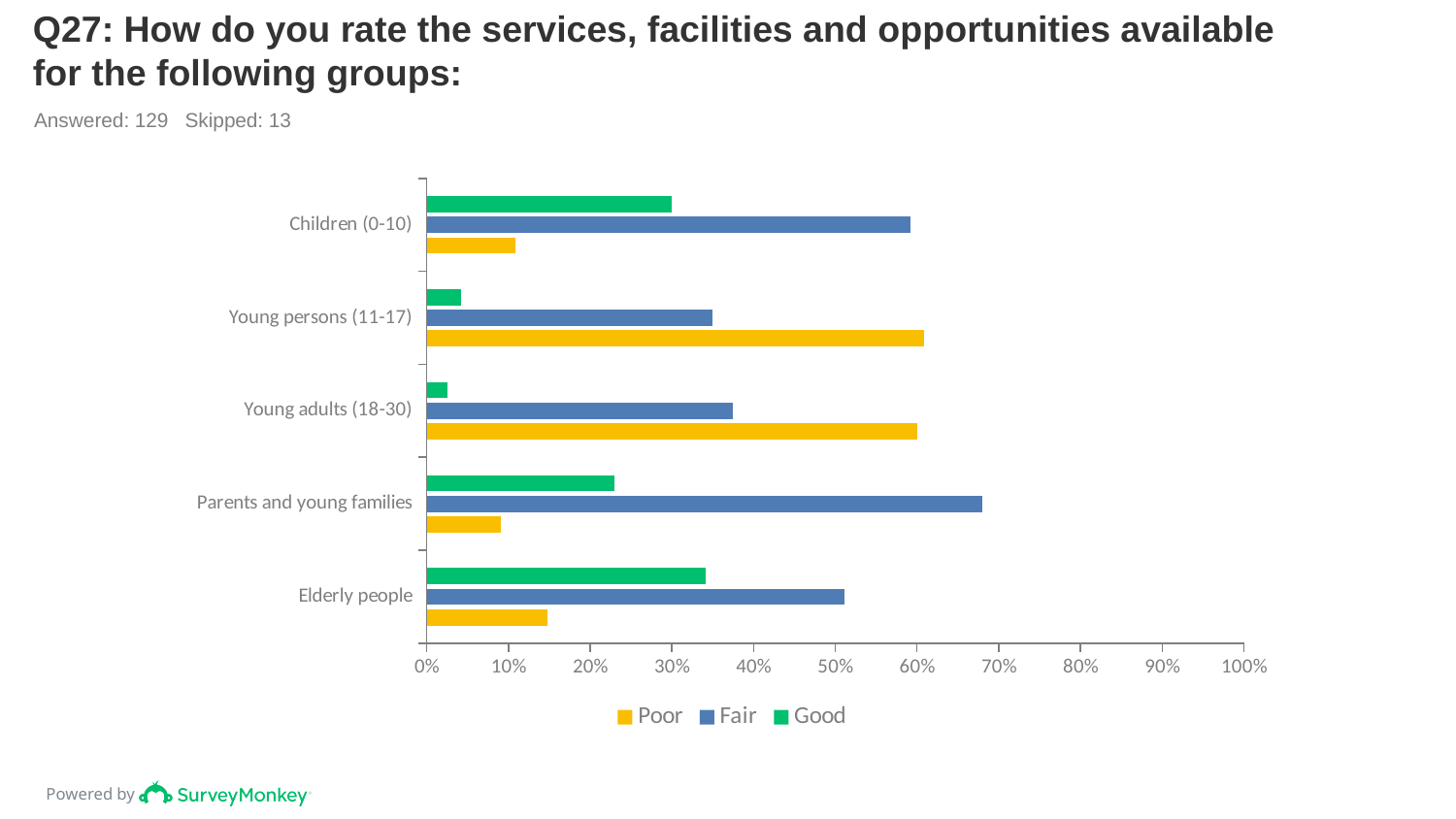
How many groups (categories) are shown on the chart? 5 Is the Poor value for Children (0-10) greater or less than 20%? less For Elderly people, which is larger: the Good value or the Poor value? Good For Children (0-10), which is larger: the Fair value or the Poor value? Fair Is the Poor value for Young adults (18-30) greater or less than 50%? greater Which group has the highest Fair rating? Parents and young families Is the Fair value for Elderly people greater or less than 40%? greater How many series does the legend list? 3 What kind of chart is shown on the slide? bar chart Which legend entry is shown in yellow? Poor